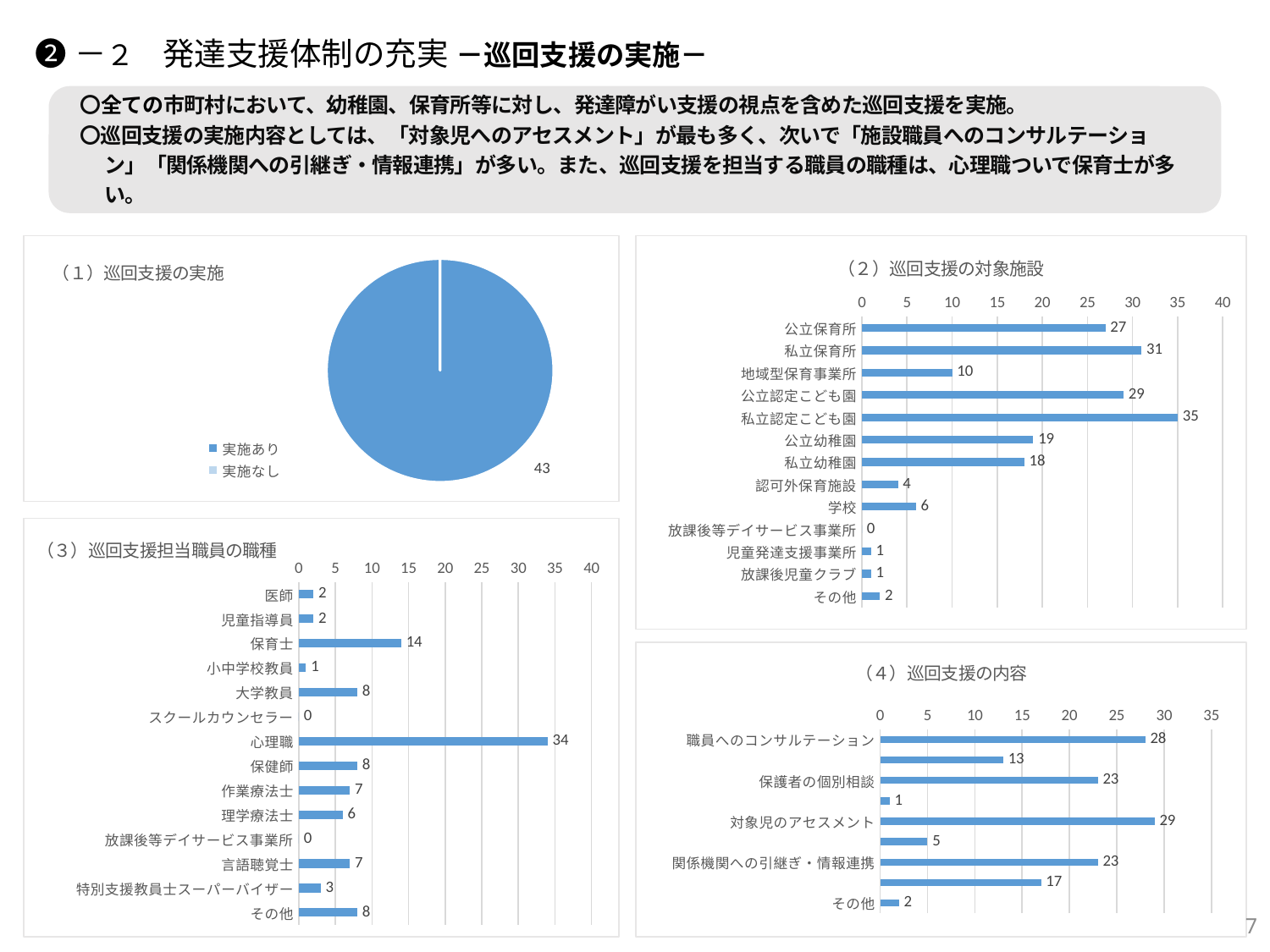
How many series does the legend of the chart titled （1）巡回支援の実施 list? 2 In the chart titled （2）巡回支援の対象施設, how many categories are plotted? 13 In the chart titled （3）巡回支援担当職員の職種, what is the value for 心理職? 34 In the chart titled （4）巡回支援の内容, what is the value for 対象児のアセスメント? 29 What kind of chart is （1）巡回支援の実施? pie chart In the chart titled （3）巡回支援担当職員の職種, how many categories are plotted? 14 In the chart titled （2）巡回支援の対象施設, what is the difference between 私立保育所 and 公立保育所? 4 In the chart titled （3）巡回支援担当職員の職種, what is the difference between 心理職 and 保育士? 20 In the chart titled （4）巡回支援の内容, which is larger, 職員へのコンサルテーション or 保護者の個別相談? 職員へのコンサルテーション In the chart titled （3）巡回支援担当職員の職種, which is larger, 保育士 or 大学教員? 保育士 In the chart titled （2）巡回支援の対象施設, what is the value for 私立認定こども園? 35 In the chart titled （2）巡回支援の対象施設, which category has the highest value? 私立認定こども園